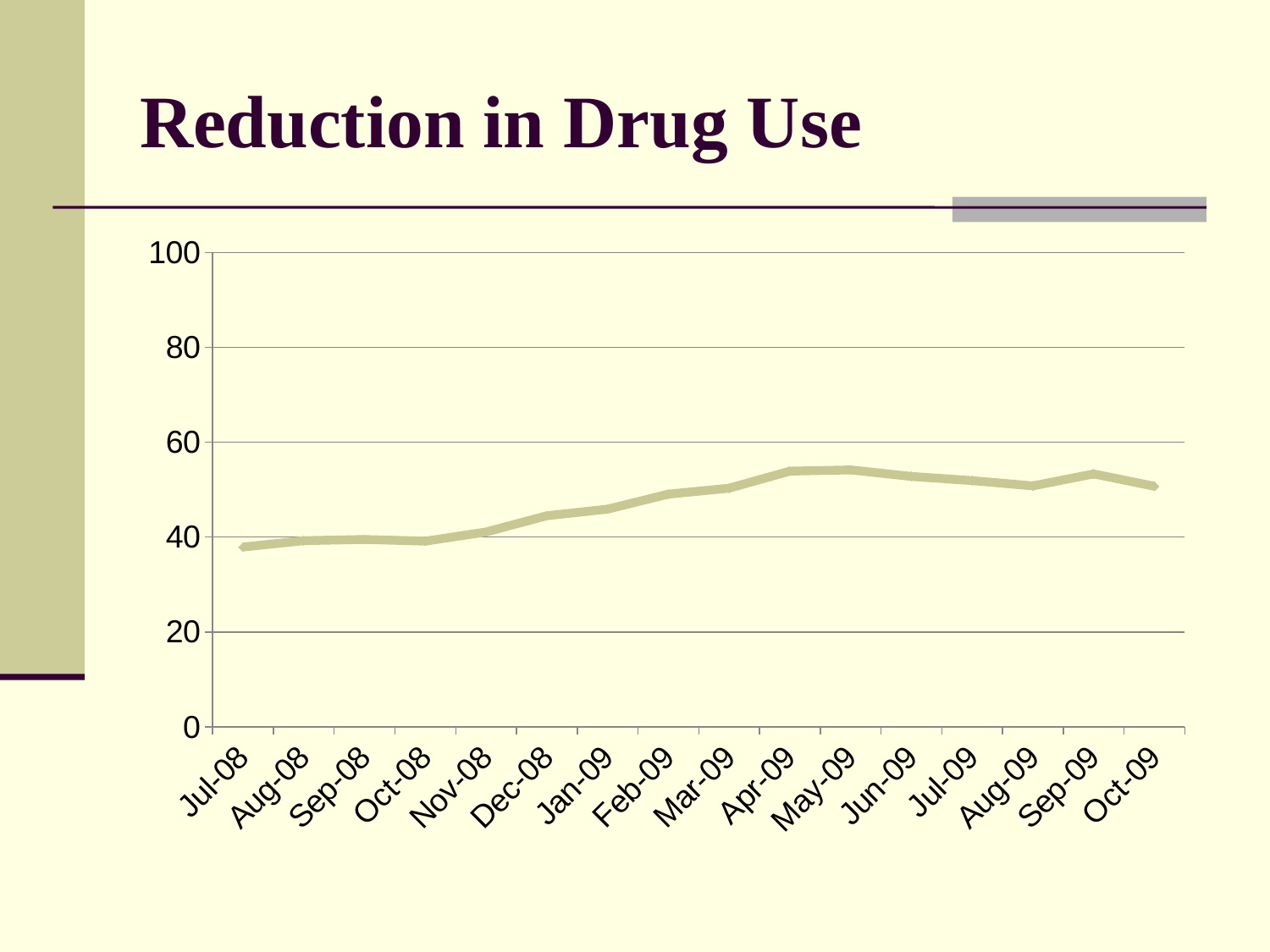
Is the value for Apr-09 greater or less than 60? less Do the values generally rise or fall from Jul-08 to Apr-09? rise Is the value for Jul-08 greater or less than 40? less Which has the larger value, Oct-08 or May-09? May-09 Which month is the first point on the x axis? Jul-08 What kind of chart is shown on the slide? line chart Is the value for Apr-09 greater or less than 40? greater How many months are plotted along the x axis of the chart? 16 What is the title of the chart on the slide? Reduction in Drug Use Which has the larger value, Jul-08 or Apr-09? Apr-09